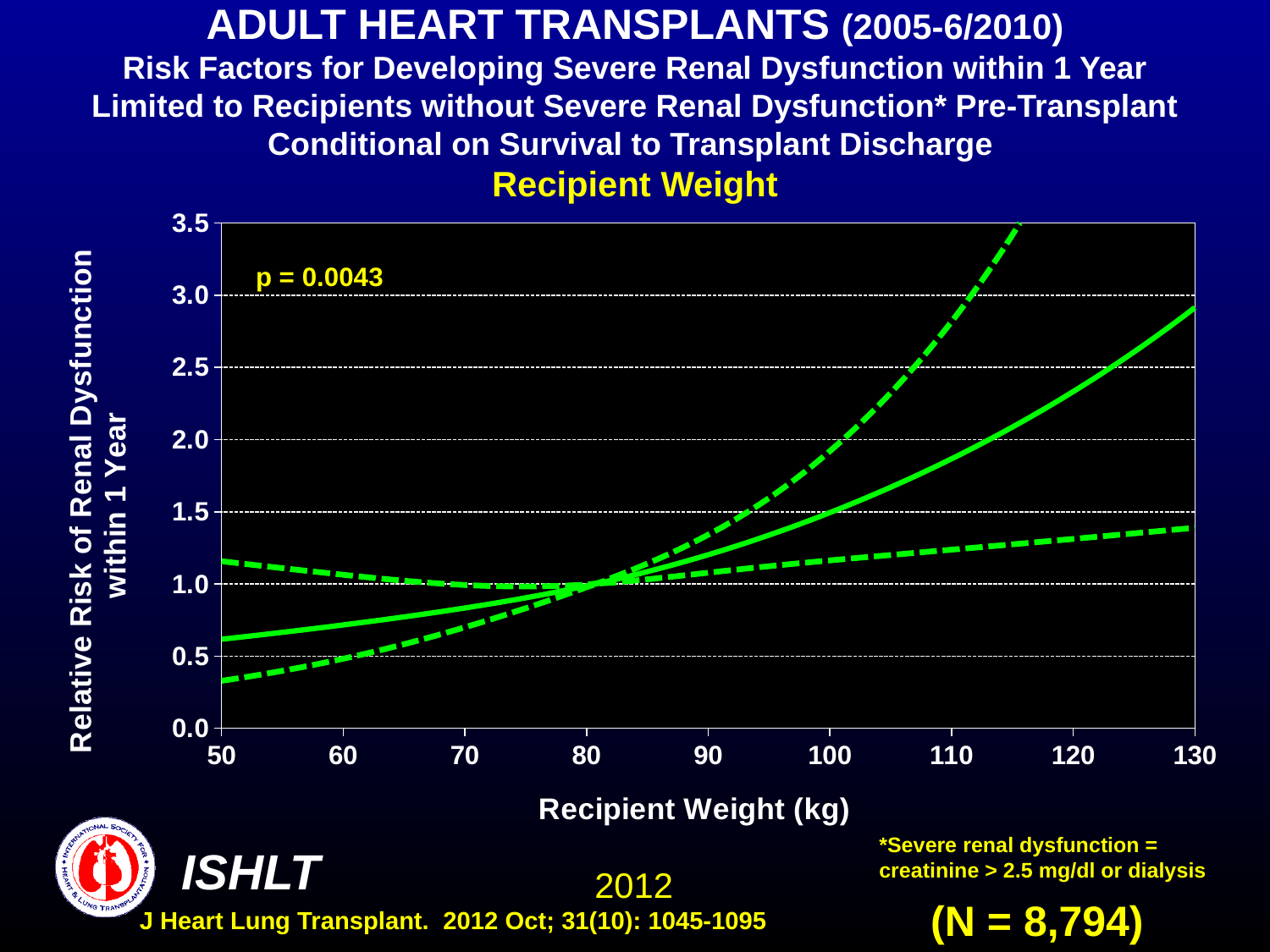
Is the lower dashed line at a recipient weight of 50 kg greater or less than 0.5? less What kind of chart is shown on the slide? line chart Is the relative risk on the solid line at a recipient weight of 130 kg greater or less than 2.5? greater What p-value is printed on the chart? p = 0.0043 Is the relative risk on the solid line at a recipient weight of 120 kg greater or less than 2.0? greater Does the solid line for relative risk of renal dysfunction rise or fall as recipient weight increases from 50 kg to 130 kg? rise How many lines are plotted on the chart? 3 What is the label of the x axis? Recipient Weight (kg)